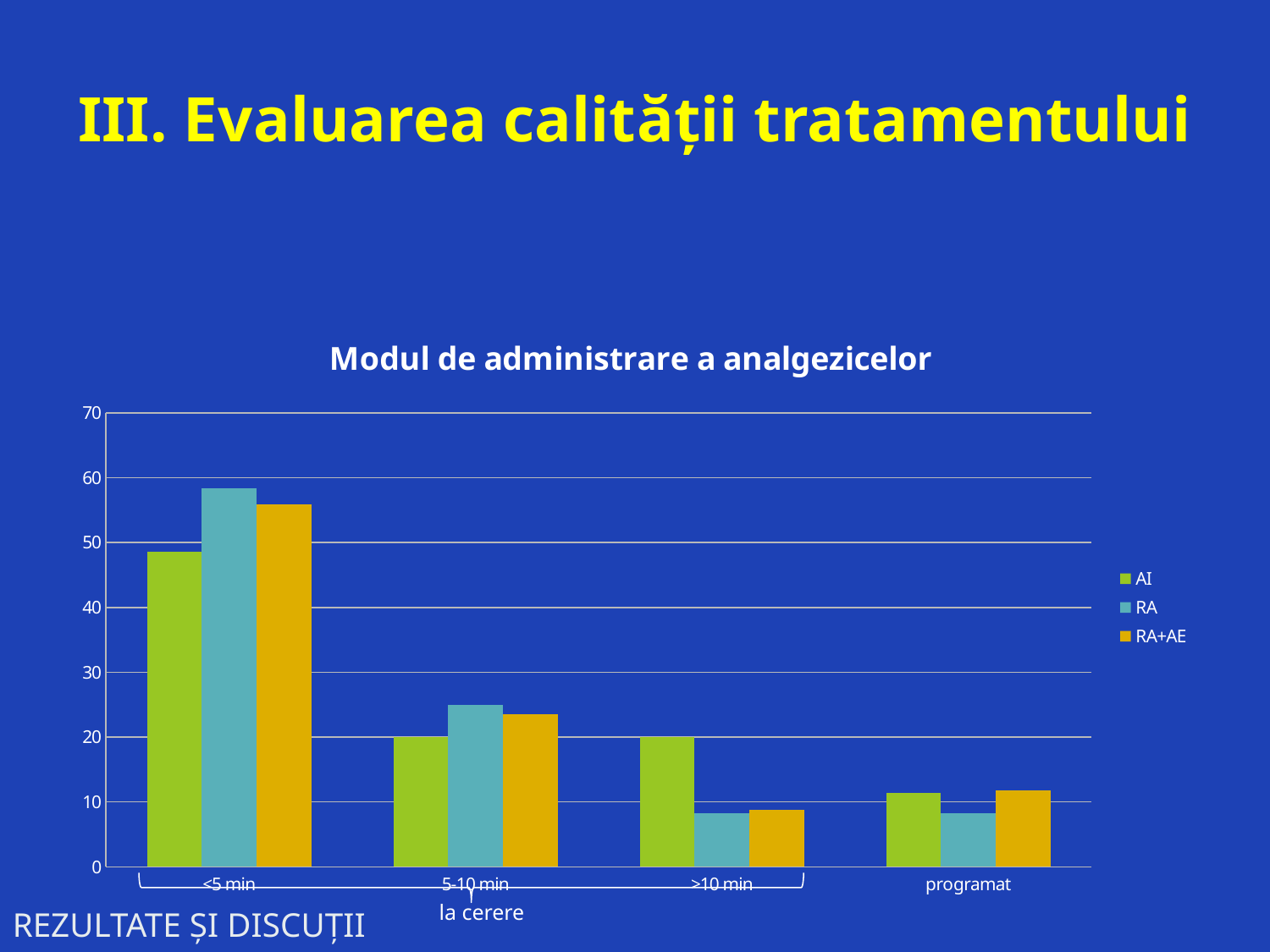
For the RA series, which category has the highest value? <5 min Is the value for AI at <5 min greater or less than 40? greater Is the value for RA at >10 min greater or less than 10? less Which series are listed in the legend? AI, RA, RA+AE What kind of chart is shown on the slide? bar chart At <5 min, which is larger: the AI value or the RA value? RA Is the value for RA+AE at 5-10 min greater or less than 20? greater How many series does the legend list? 3 At >10 min, which is larger: the AI value or the RA value? AI What is the title of the chart? Modul de administrare a analgezicelor For the AI series, which category has the lowest value? programat How many categories are shown on the x axis? 4